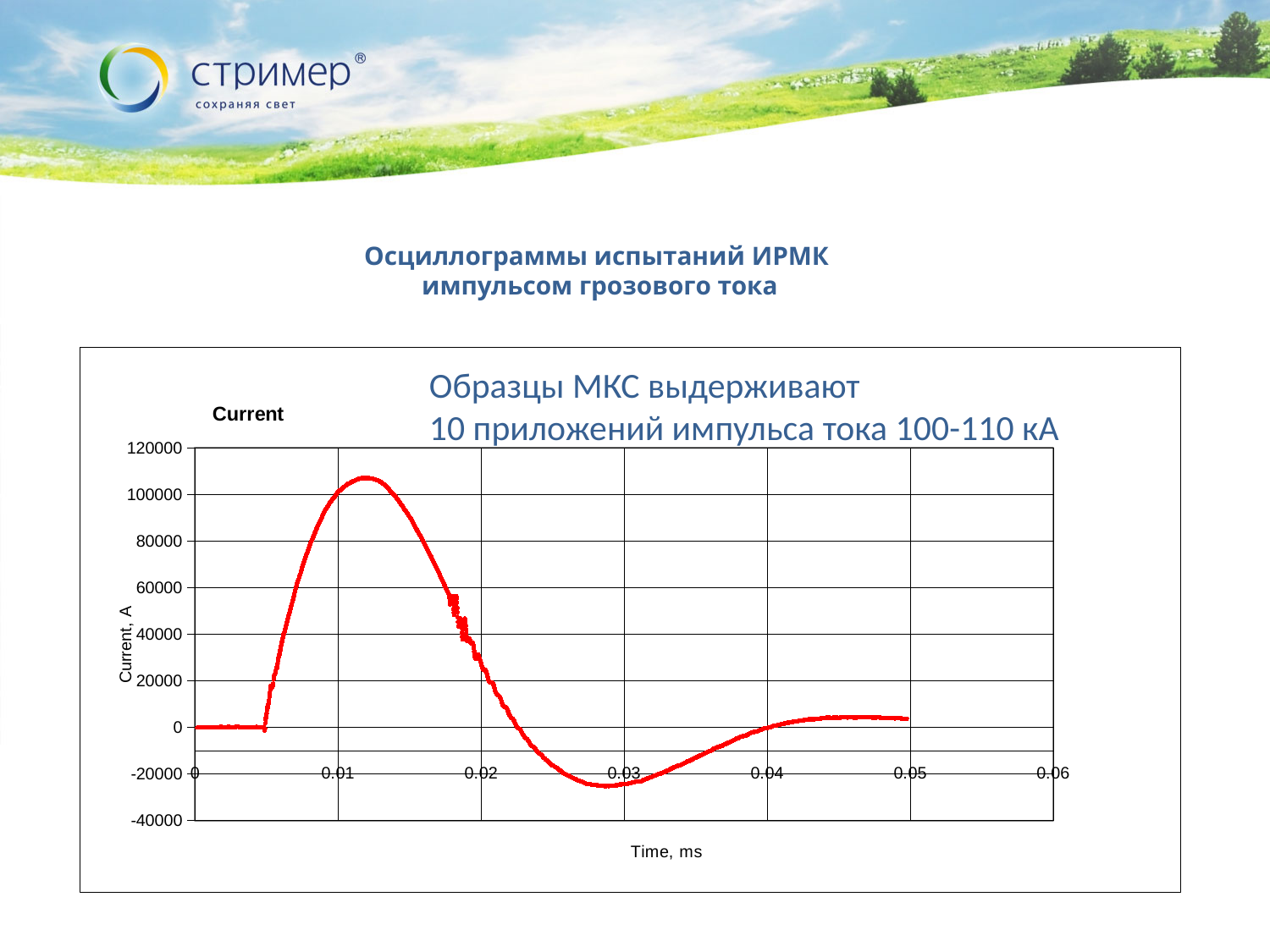
What is the title of the chart? Current What is the highest value shown on the y axis of the chart? 120000 Is the peak value of the current curve greater or less than 120000? less Is the peak value of the current curve greater or less than 100000? greater What kind of chart is shown on the slide? line chart Does the current rise or fall between time 0.01 and time 0.02? fall Is the value of the current at time 0.01 greater or less than 80000? greater What is the label of the x axis of the chart? Time, ms Is the current at time 0.01 larger or smaller than the current at time 0.03? larger Does the current rise or fall between time 0.03 and time 0.04? rise